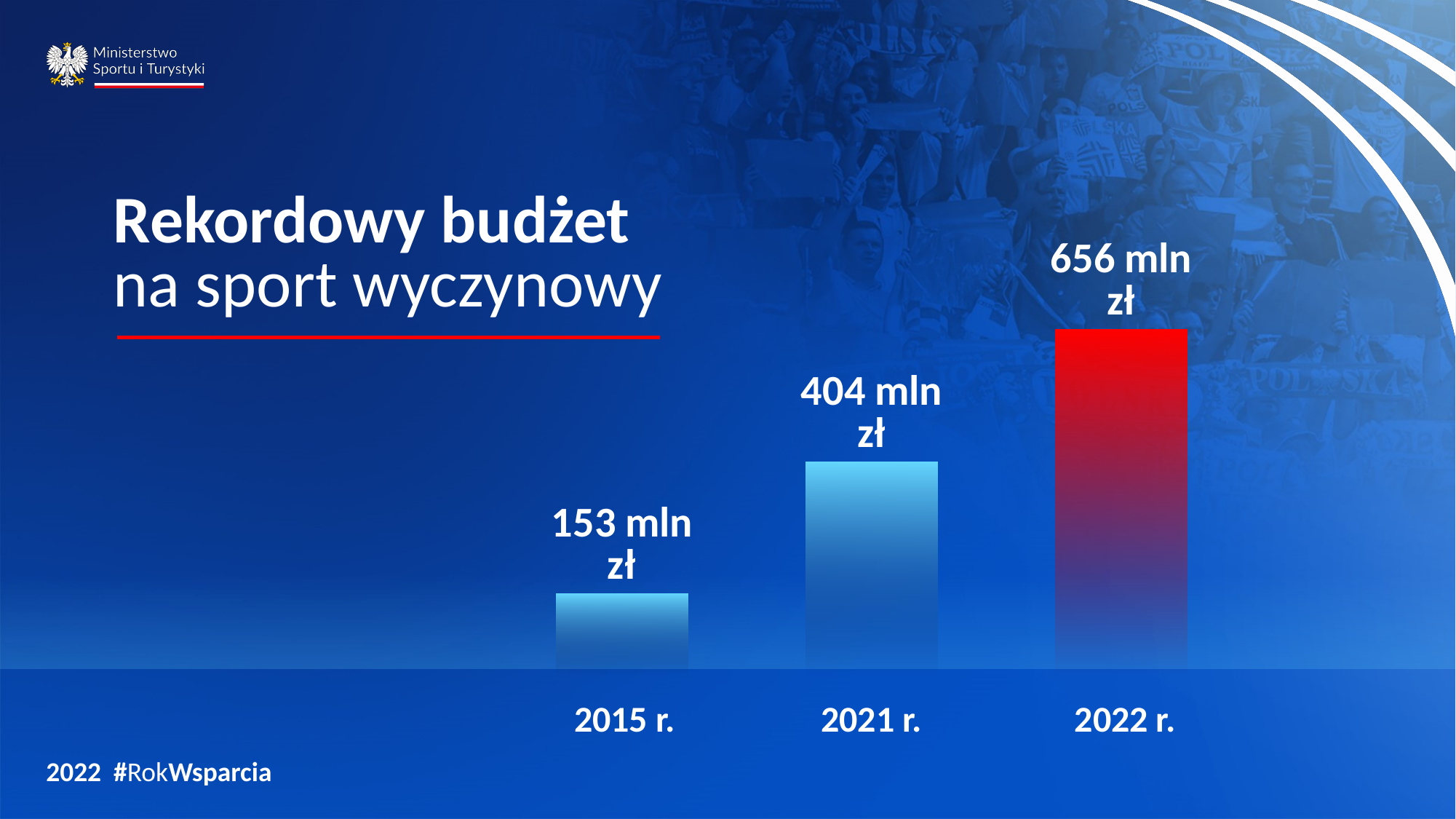
Which year has the highest value? 2022 r. Which is larger, the value for 2015 r. or the value for 2021 r.? 2021 r. Do the values rise or fall from 2015 r. to 2022 r.? rise What is the value shown for 2022 r.? 656 mln zł Which year has the lowest value? 2015 r. What is the difference between the values for 2021 r. and 2015 r.? 251 mln zł What kind of chart is shown on the slide? bar chart What is the value shown for 2015 r.? 153 mln zł How many years are shown in the chart? 3 Which bar is coloured red? 2022 r. What is the value shown for 2021 r.? 404 mln zł What is the difference between the values for 2022 r. and 2021 r.? 252 mln zł